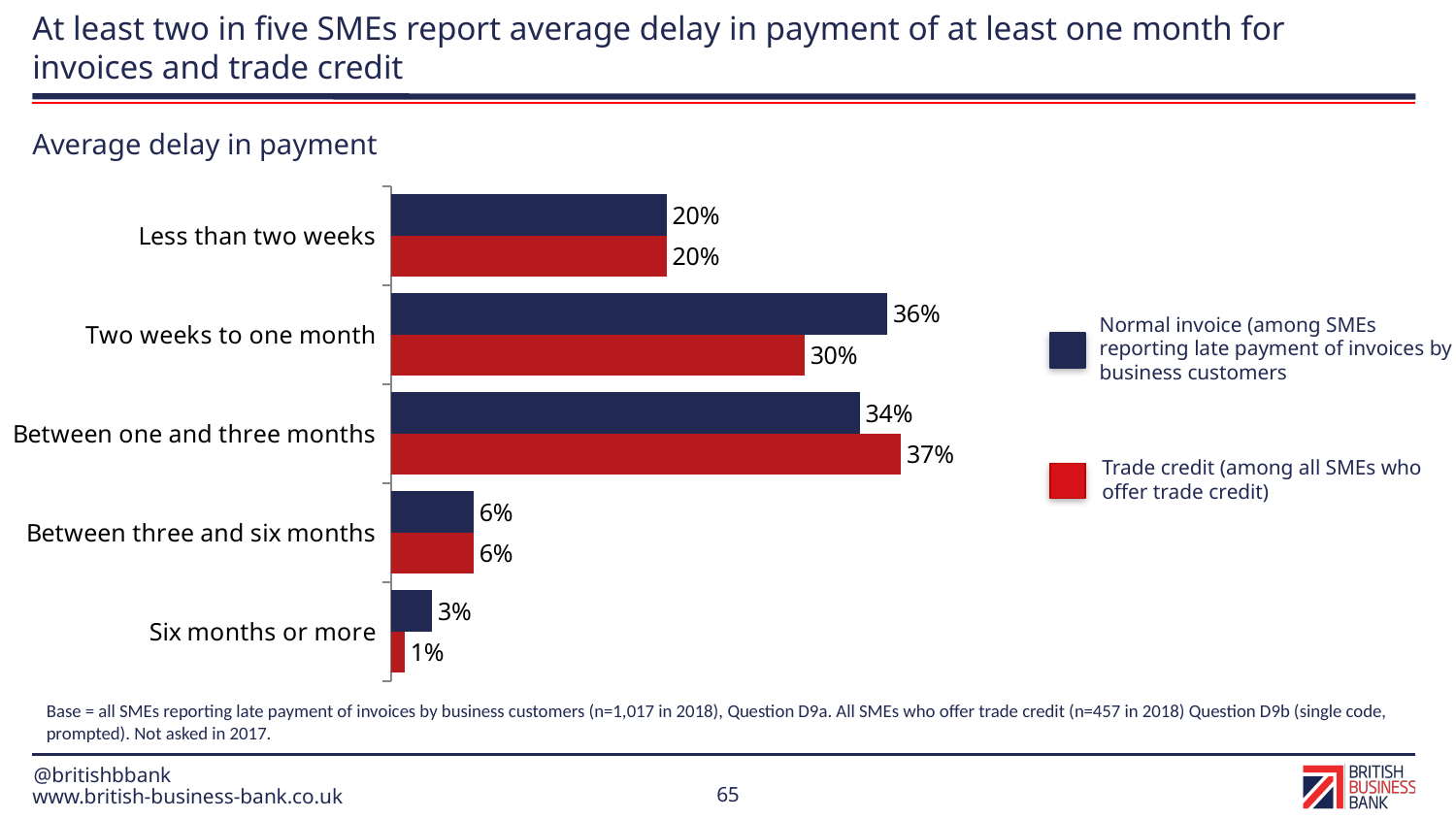
For 'Between one and three months', which series has the larger value, Normal invoice or Trade credit? Trade credit What is the Trade credit value for 'Six months or more'? 1% What kind of chart is shown on the slide? Bar chart Which category has the lowest Trade credit value? Six months or more What is the title of the chart? Average delay in payment What is the Trade credit value for 'Between one and three months'? 37% How many series does the legend list? 2 What colour represents the Trade credit series? Red What is the Normal invoice value for 'Two weeks to one month'? 36% How many delay categories are shown on the chart? 5 What is the difference between the Normal invoice and Trade credit values for 'Two weeks to one month'? 6% Which category has the highest Normal invoice value? Two weeks to one month